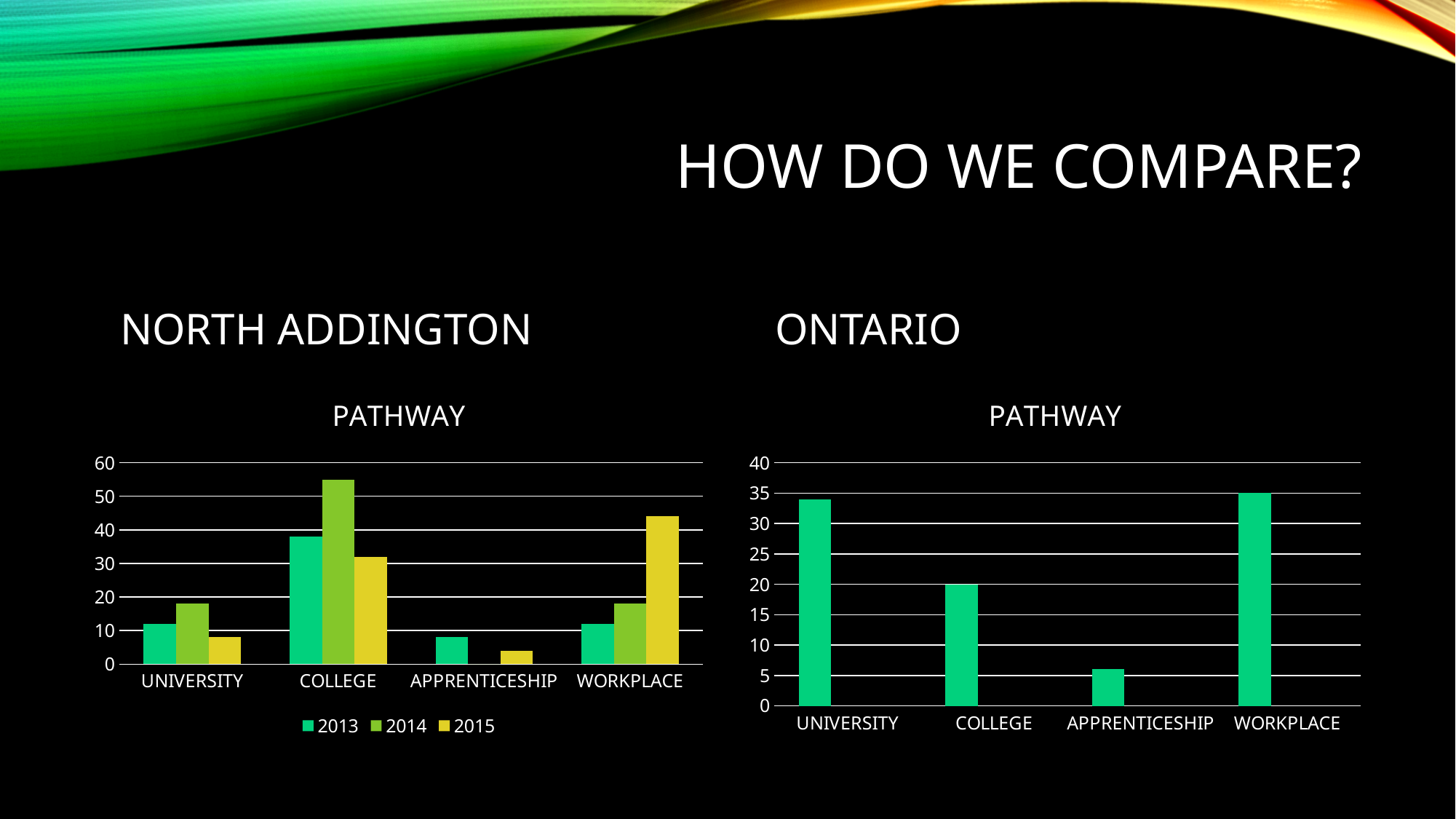
In the North Addington chart, which category has the highest value for 2014? College How many series does the legend of the North Addington chart list? 3 In the North Addington chart, is the 2014 value for College greater or less than 50? greater What kind of chart is the North Addington PATHWAY chart on the left? bar chart In the North Addington chart, which category has the highest value for 2015? Workplace In the North Addington chart, is the 2015 value for Apprenticeship greater or less than 10? less In the Ontario chart, which category has the lowest value? Apprenticeship What are the legend entries of the North Addington chart? 2013, 2014, 2015 In the Ontario chart, is the value for University greater or less than 30? greater In the North Addington chart, which is larger for University: the 2014 value or the 2015 value? 2014 How many categories are shown on the x axis of the Ontario PATHWAY chart on the right? 4 In the Ontario chart, what is the value for College? 20